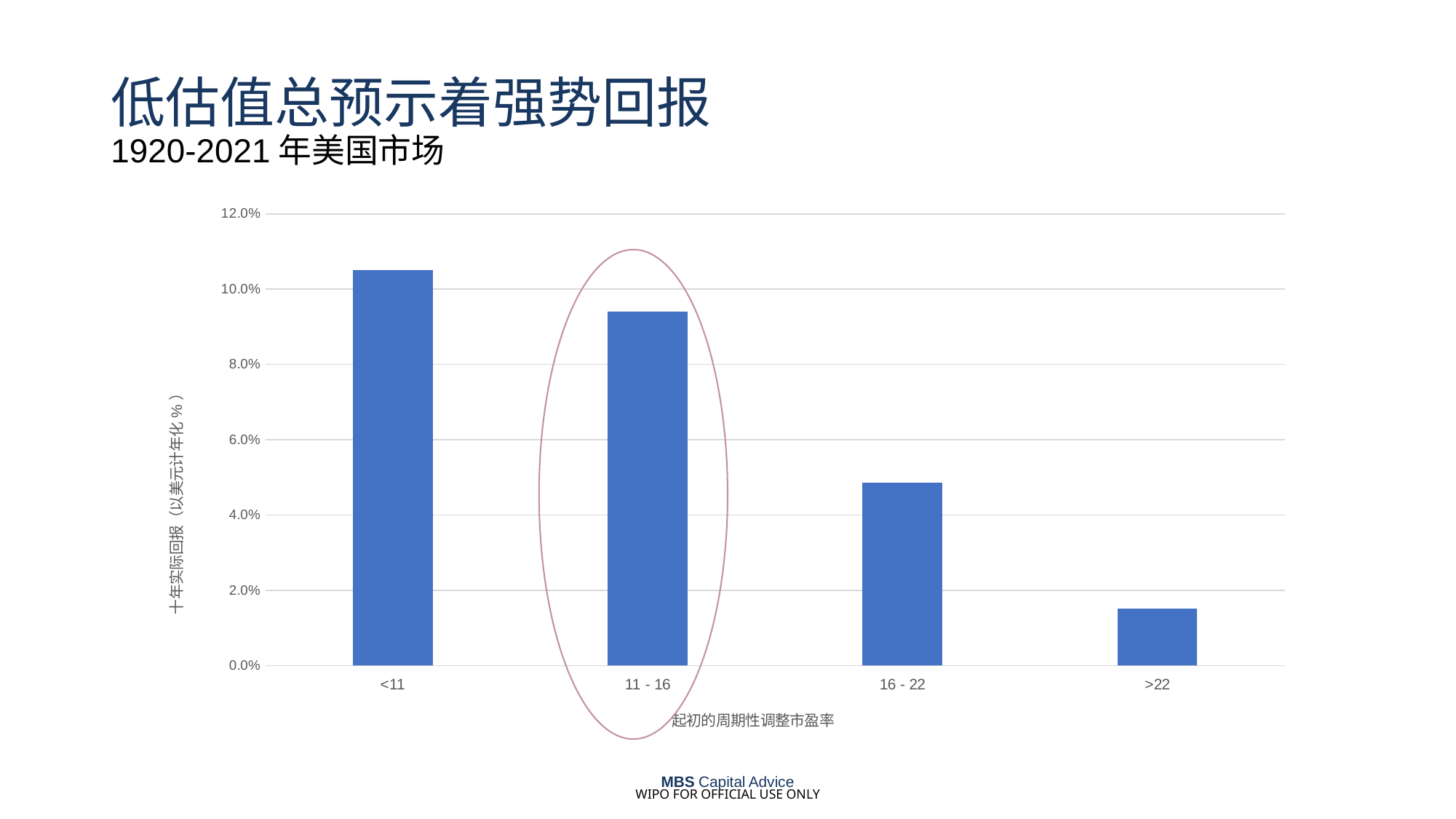
Is the value for 11 - 16 greater or less than 10.0%? less What is the label of the x axis of the chart? 起初的周期性调整市盈率 How many categories are shown on the x axis of the chart? 4 Do the values rise or fall as you move from <11 to >22 along the x axis? fall Which category has the highest ten-year real return? <11 Which category has the lowest ten-year real return? >22 What kind of chart is shown on the slide? bar chart Is the value for 16 - 22 greater or less than 6.0%? less Which bar is circled on the chart? 11 - 16 Is the value for >22 greater or less than 2.0%? less Which is larger, the value for 11 - 16 or the value for 16 - 22? 11 - 16